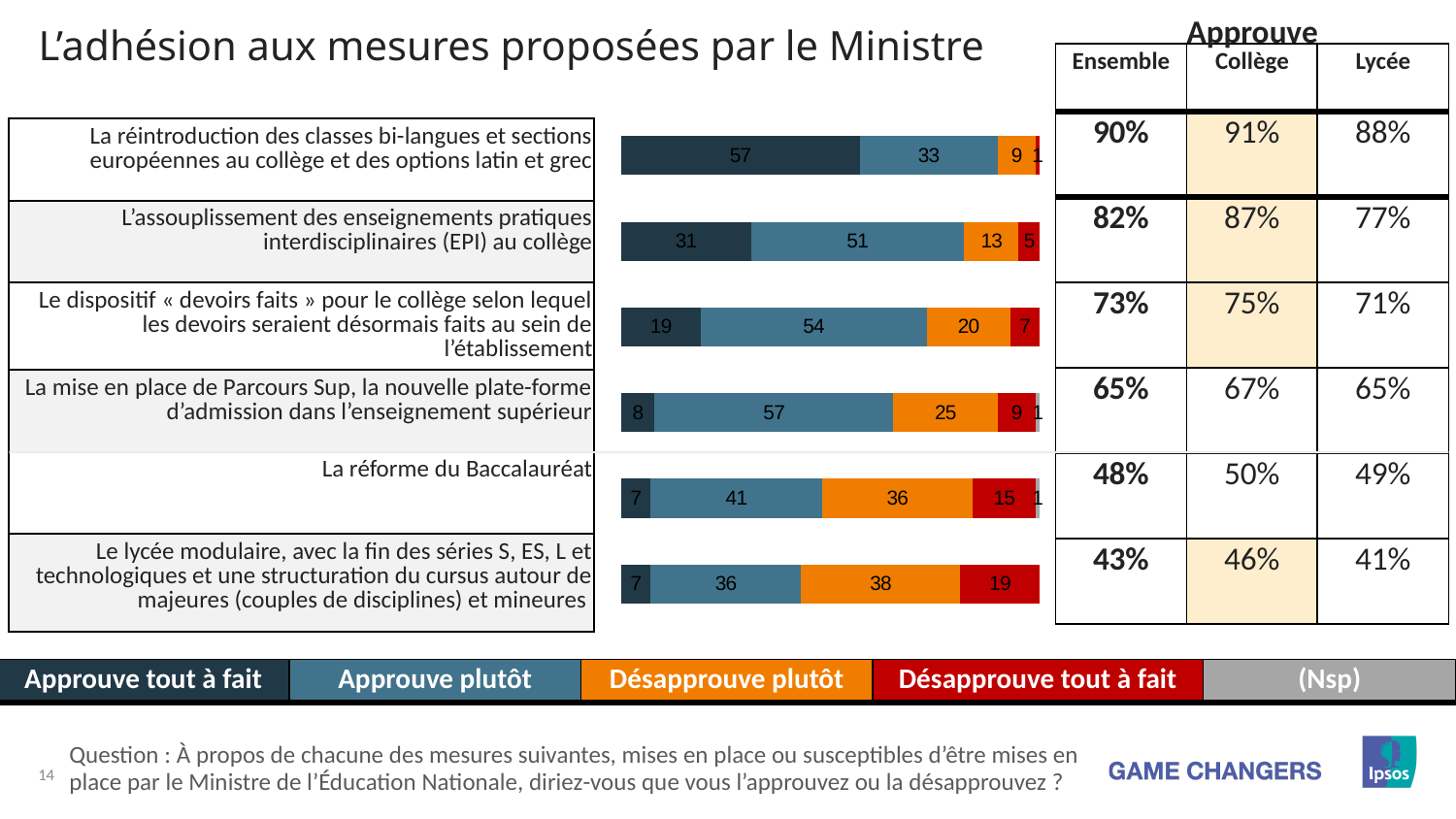
Which measure has the lowest 'Ensemble' approval percentage in the table? Le lycée modulaire, avec la fin des séries S, ES, L et technologiques et une structuration du cursus autour de majeures (couples de disciplines) et mineures What is the 'Approuve plutôt' value for 'L'assouplissement des enseignements pratiques interdisciplinaires (EPI) au collège'? 51 How many series does the legend list? 5 What is the difference between the 'Approuve plutôt' values for 'Le dispositif « devoirs faits »' (54) and 'La réforme du Baccalauréat' (41)? 13 What is the 'Approuve tout à fait' value for 'La réintroduction des classes bi-langues et sections européennes au collège et des options latin et grec'? 57 What is the 'Désapprouve tout à fait' value for 'La réforme du Baccalauréat'? 15 Which measure has the highest 'Approuve tout à fait' value? La réintroduction des classes bi-langues et sections européennes au collège et des options latin et grec Which is larger: the 'Désapprouve plutôt' value for 'La mise en place de Parcours Sup' or for 'La réforme du Baccalauréat'? La réforme du Baccalauréat How many measures (categories) are plotted in the chart? 6 What kind of chart is shown on the slide? Stacked bar chart What colour represents 'Désapprouve tout à fait' in the legend? Red What is the 'Désapprouve plutôt' value for 'Le lycée modulaire, avec la fin des séries S, ES, L et technologiques...'? 38